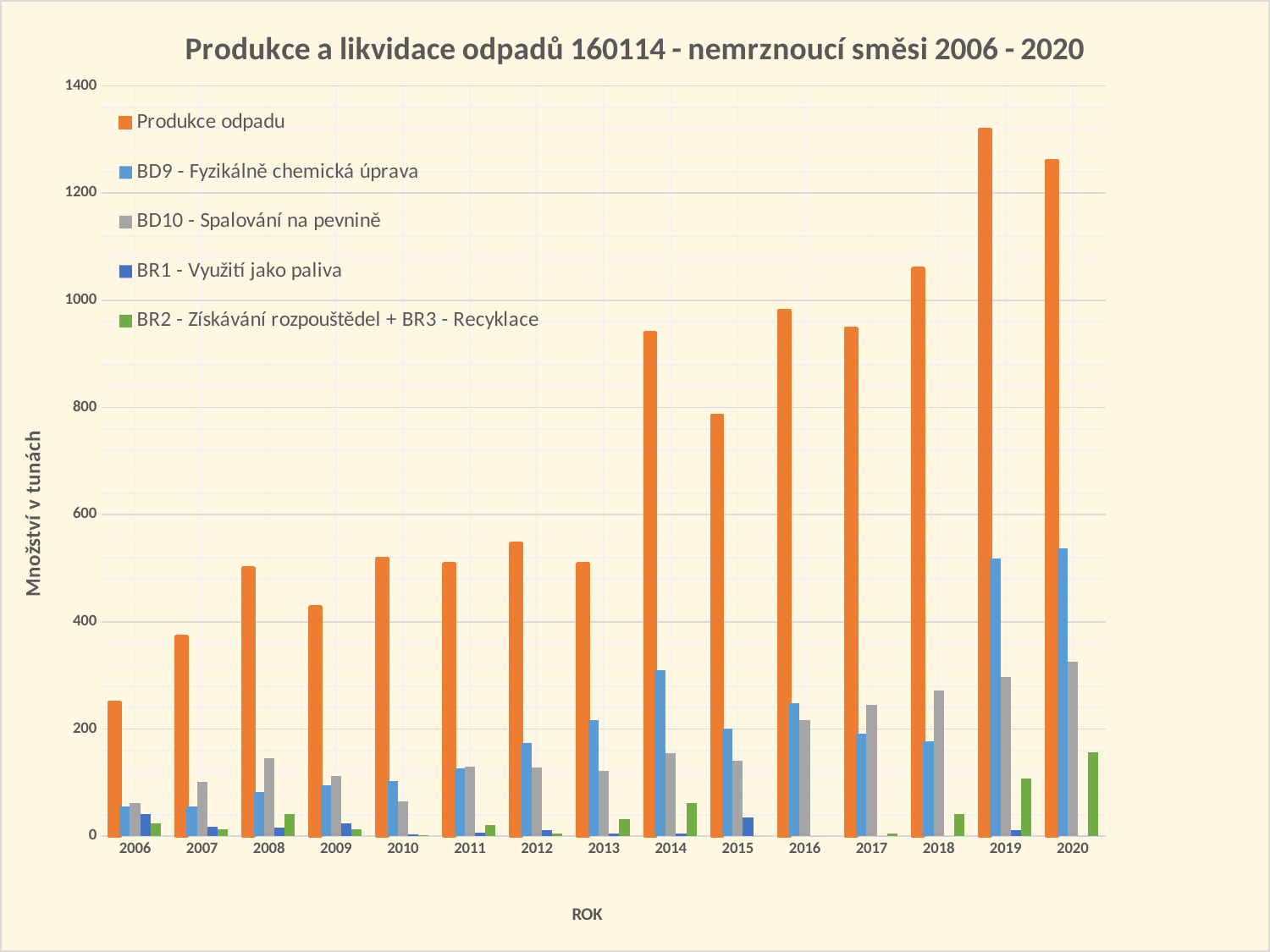
Which year has the larger Produkce odpadu value, 2015 or 2016? 2016 Is the value of Produkce odpadu in 2014 greater or less than 800? greater In which year is Produkce odpadu highest? 2019 Is the value of BD9 - Fyzikálně chemická úprava in 2019 greater or less than 400? greater What type of chart is shown on the slide? Bar chart Does Produkce odpadu generally rise or fall from 2006 to 2020? Rise In 2017, which is larger: BD9 - Fyzikálně chemická úprava or BD10 - Spalování na pevnině? BD10 - Spalování na pevnině How many series does the legend list? 5 In which year is Produkce odpadu lowest? 2006 How many years are shown on the x axis? 15 Is the value of BR2 - Získávání rozpouštědel + BR3 - Recyklace in 2020 greater or less than 100? greater